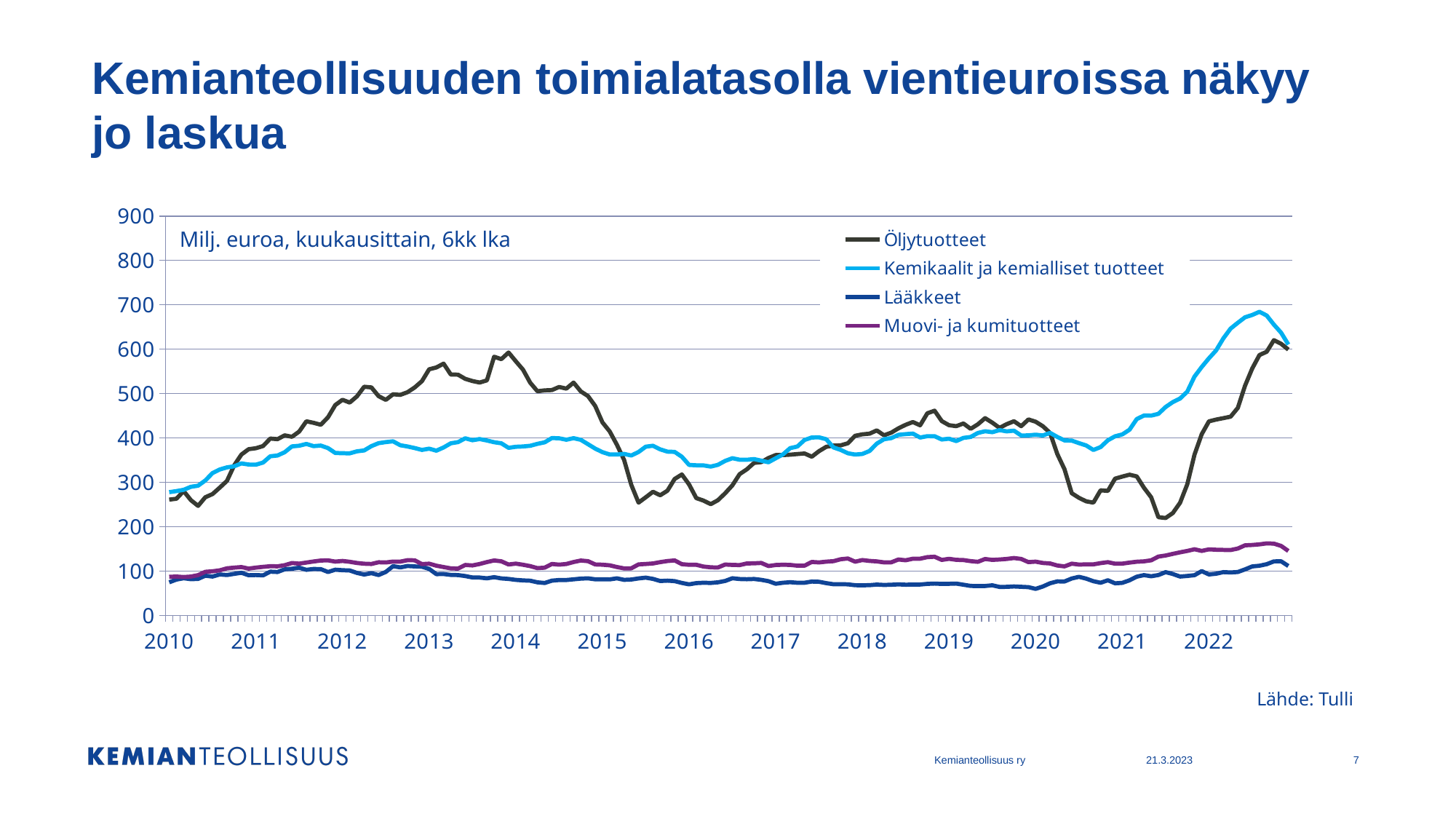
Is the peak value of Kemikaalit ja kemialliset tuotteet in 2022 greater or less than 600? greater What unit description is printed inside the chart area? Milj. euroa, kuukausittain, 6kk lka What kind of chart is shown on the slide? line chart How many series does the legend list? 4 Does the Öljytuotteet line rise or fall between 2014 and 2015? fall Is the lowest value of Öljytuotteet around 2021 greater or less than 300? less Which series are listed in the legend? Öljytuotteet, Kemikaalit ja kemialliset tuotteet, Lääkkeet, Muovi- ja kumituotteet Which series reaches the highest value anywhere on the chart? Kemikaalit ja kemialliset tuotteet Which series stays lowest for most of the period shown? Lääkkeet In 2013, which is higher, Öljytuotteet or Kemikaalit ja kemialliset tuotteet? Öljytuotteet Is the value for Muovi- ja kumituotteet at the end of 2022 greater or less than 100? greater In 2016, which is higher, Öljytuotteet or Kemikaalit ja kemialliset tuotteet? Kemikaalit ja kemialliset tuotteet